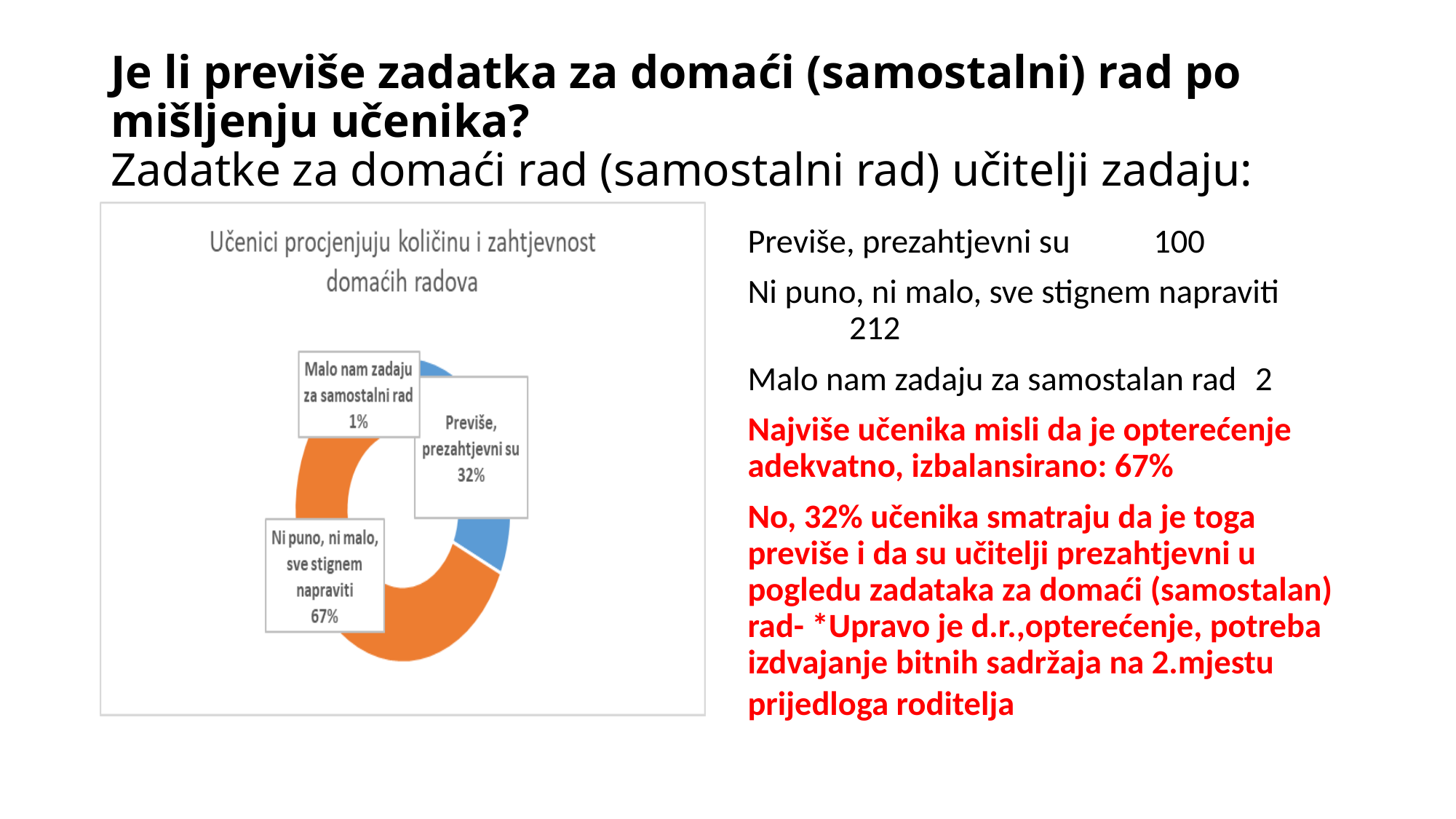
What percentage is shown for 'Ni puno, ni malo, sve stignem napraviti'? 67% What kind of chart is shown on the slide? Doughnut (pie) chart What is the title of the chart? Učenici procjenjuju količinu i zahtjevnost domaćih radova What percentage is shown for 'Malo nam zadaju za samostalni rad'? 1% What is the combined share of 'Previše, prezahtjevni su' and 'Malo nam zadaju za samostalni rad'? 33% What is the difference in percentage points between 'Ni puno, ni malo, sve stignem napraviti' and 'Previše, prezahtjevni su'? 35 percentage points How many categories (slices) does the chart show? 3 What percentage is shown for 'Previše, prezahtjevni su'? 32% Which category has the smallest share of the chart? Malo nam zadaju za samostalni rad What colour is the slice for 'Ni puno, ni malo, sve stignem napraviti'? Orange Which category has the largest share of the chart? Ni puno, ni malo, sve stignem napraviti Which is larger: the share for 'Previše, prezahtjevni su' or the share for 'Malo nam zadaju za samostalni rad'? Previše, prezahtjevni su